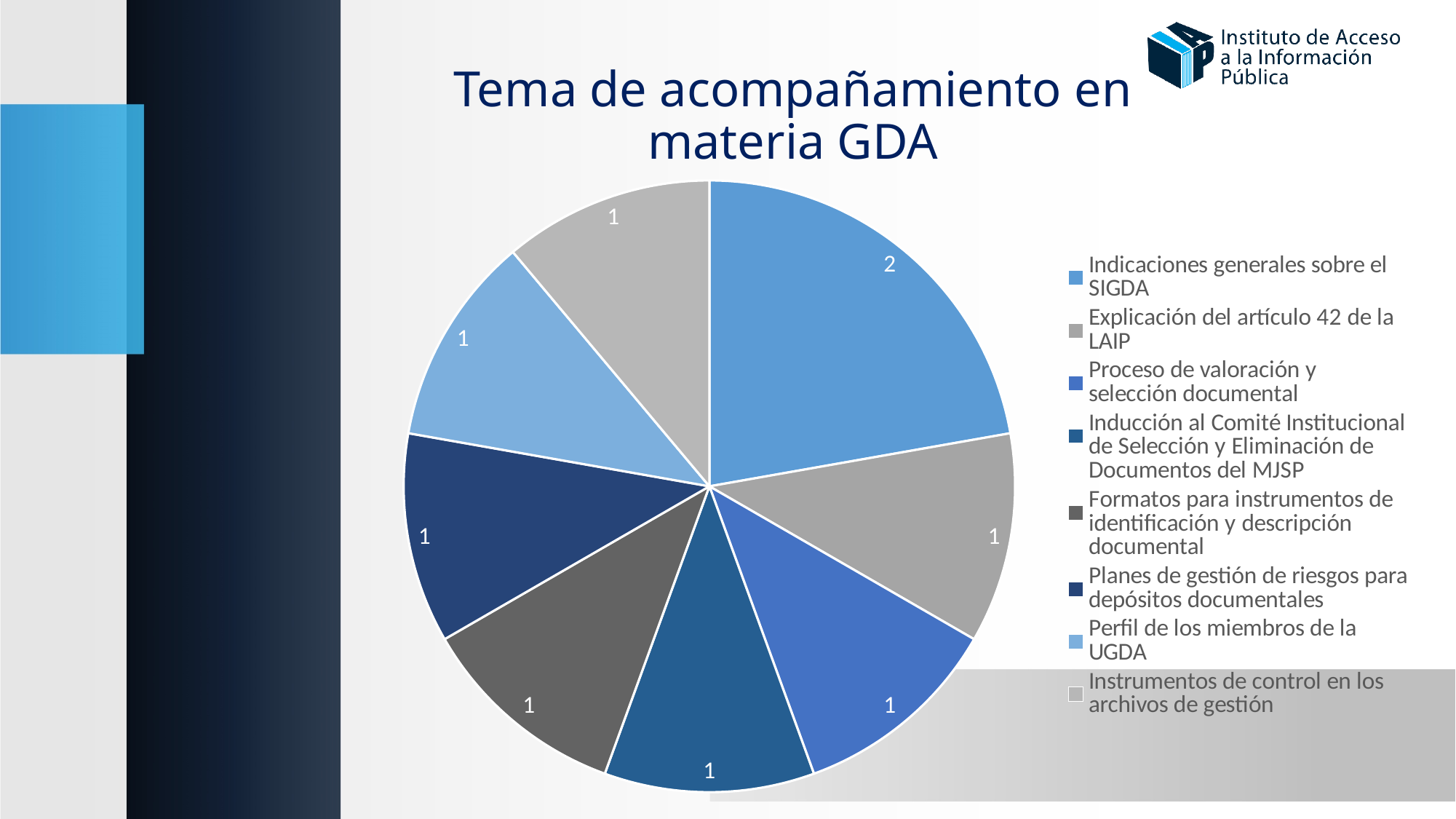
What is the difference between the value for "Indicaciones generales sobre el SIGDA" and the value for "Planes de gestión de riesgos para depósitos documentales"? 1 Which is larger: the value for "Indicaciones generales sobre el SIGDA" or the value for "Proceso de valoración y selección documental"? Indicaciones generales sobre el SIGDA How many slices does the pie chart have? 8 What is the title of the chart on the slide? Tema de acompañamiento en materia GDA Which legend entry is shown with a light grey marker at the bottom of the legend? Instrumentos de control en los archivos de gestión What is the total of all the values shown in the pie chart? 9 What is the value for "Explicación del artículo 42 de la LAIP"? 1 What is the value for "Indicaciones generales sobre el SIGDA"? 2 How many entries does the legend list? 8 Which category has the largest slice of the pie? Indicaciones generales sobre el SIGDA What is the value for "Perfil de los miembros de la UGDA"? 1 What kind of chart is shown on the slide? Pie chart